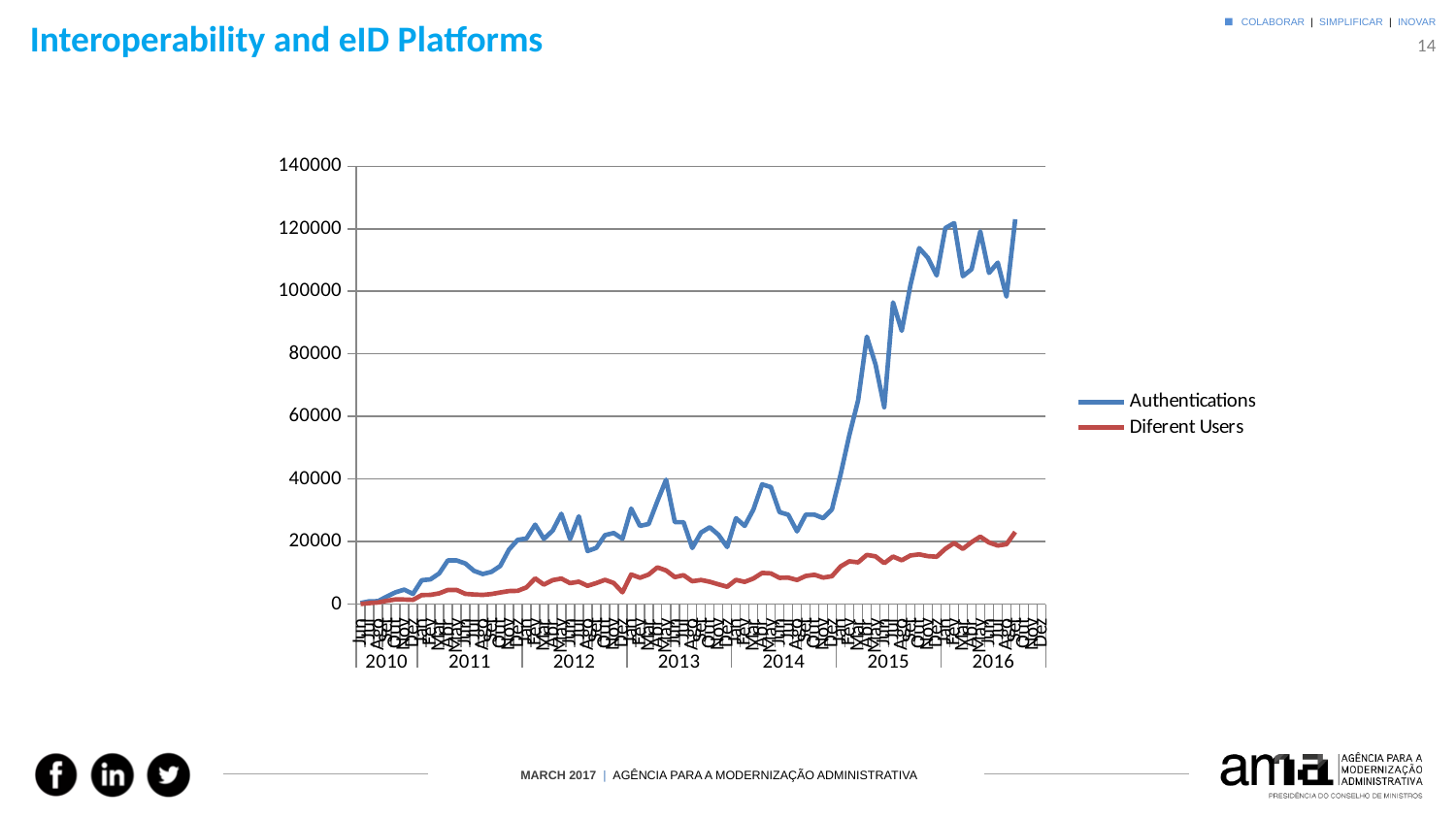
Which series reaches higher values overall, Authentications or Diferent Users? Authentications How many years are labelled along the x axis? 7 Is the highest value of the Diferent Users line greater or less than 40000? less Do the Diferent Users values generally rise or fall from 2010 to 2016? rise What are the two series named in the legend? Authentications and Diferent Users Is the highest value of the Authentications line greater or less than 100000? greater How many series does the legend list? 2 Which colour is used for the Authentications line? blue What kind of chart is shown on the slide? line chart Do the Authentications values generally rise or fall from 2010 to 2016? rise Is the value of Authentications at the start of 2010 greater or less than 20000? less